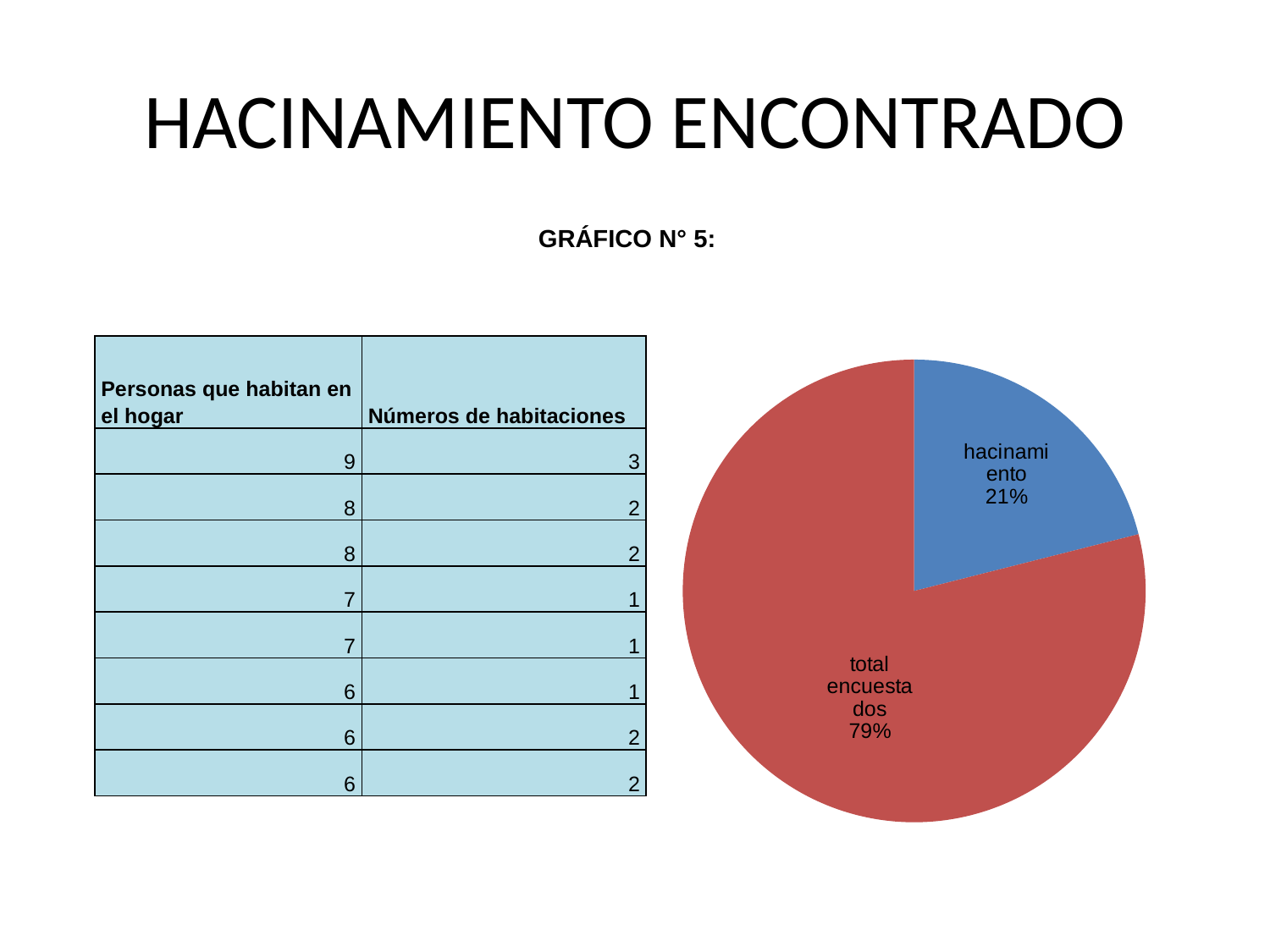
Which slice of the pie chart is the smallest? hacinamiento Which slice of the pie chart is the largest? total encuestados What share of the pie does the "hacinamiento" slice represent? 21% What share of the pie does the "total encuestados" slice represent? 79% By how many percentage points does the "total encuestados" slice exceed the "hacinamiento" slice? 58 Which is larger in the pie chart, "hacinamiento" or "total encuestados"? total encuestados What colour is the "total encuestados" slice in the pie chart? red How many slices does the pie chart have? 2 What kind of chart is shown on the slide? pie chart What colour is the "hacinamiento" slice in the pie chart? blue